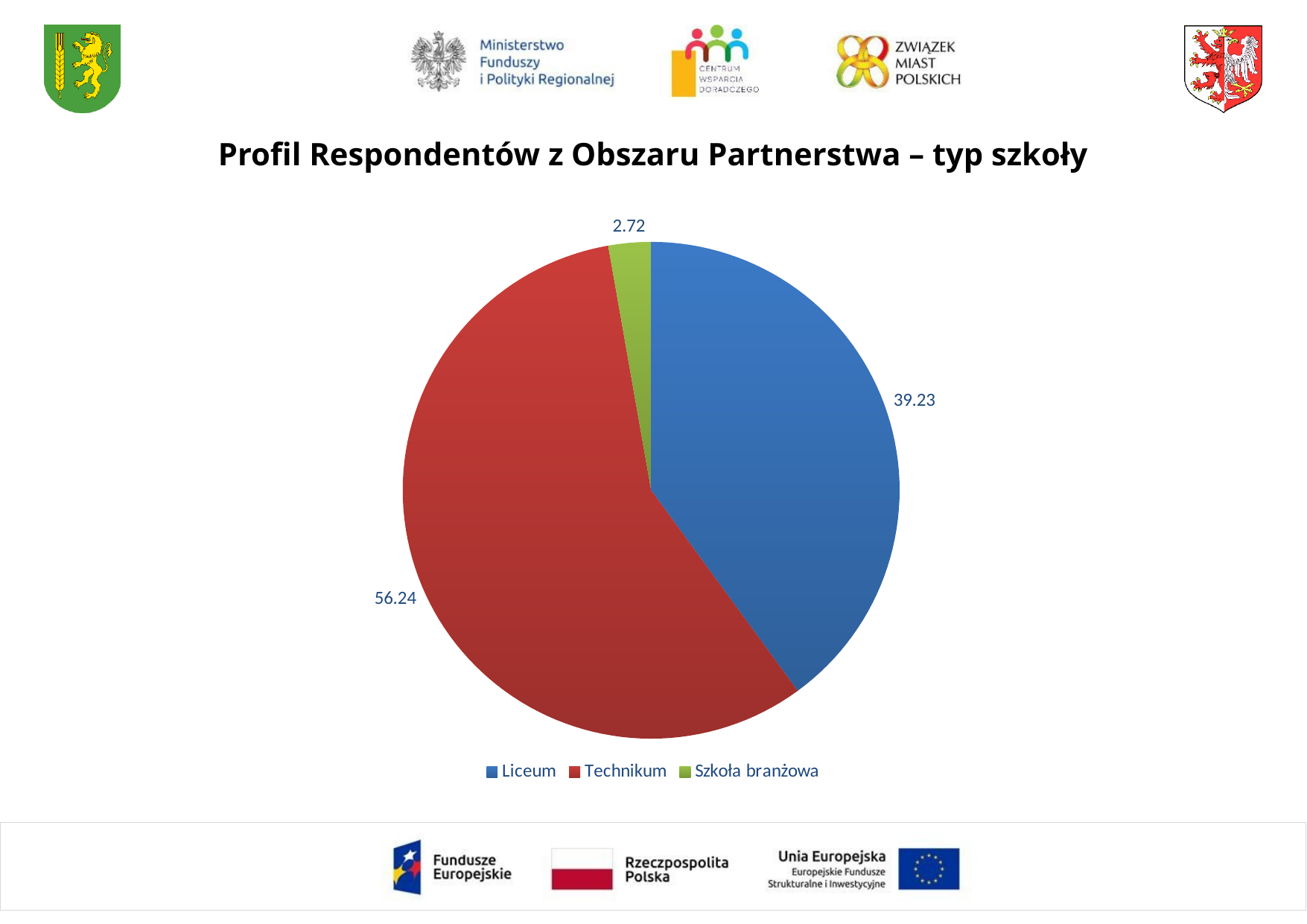
Which school type has the largest slice of the pie? Technikum How many entries does the legend list? 3 How many slices does the pie chart have? 3 Which is larger, the value for Liceum or the value for Szkoła branżowa? Liceum Which school type has the smallest slice of the pie? Szkoła branżowa What value is shown for Technikum? 56.24 What is the difference between the values for Technikum and Liceum? 17.01 What kind of chart is shown on the slide? Pie chart What value is shown for Szkoła branżowa? 2.72 What is the title of the chart? Profil Respondentów z Obszaru Partnerstwa – typ szkoły What value is shown for Liceum? 39.23 What colour is the slice for Technikum? Red